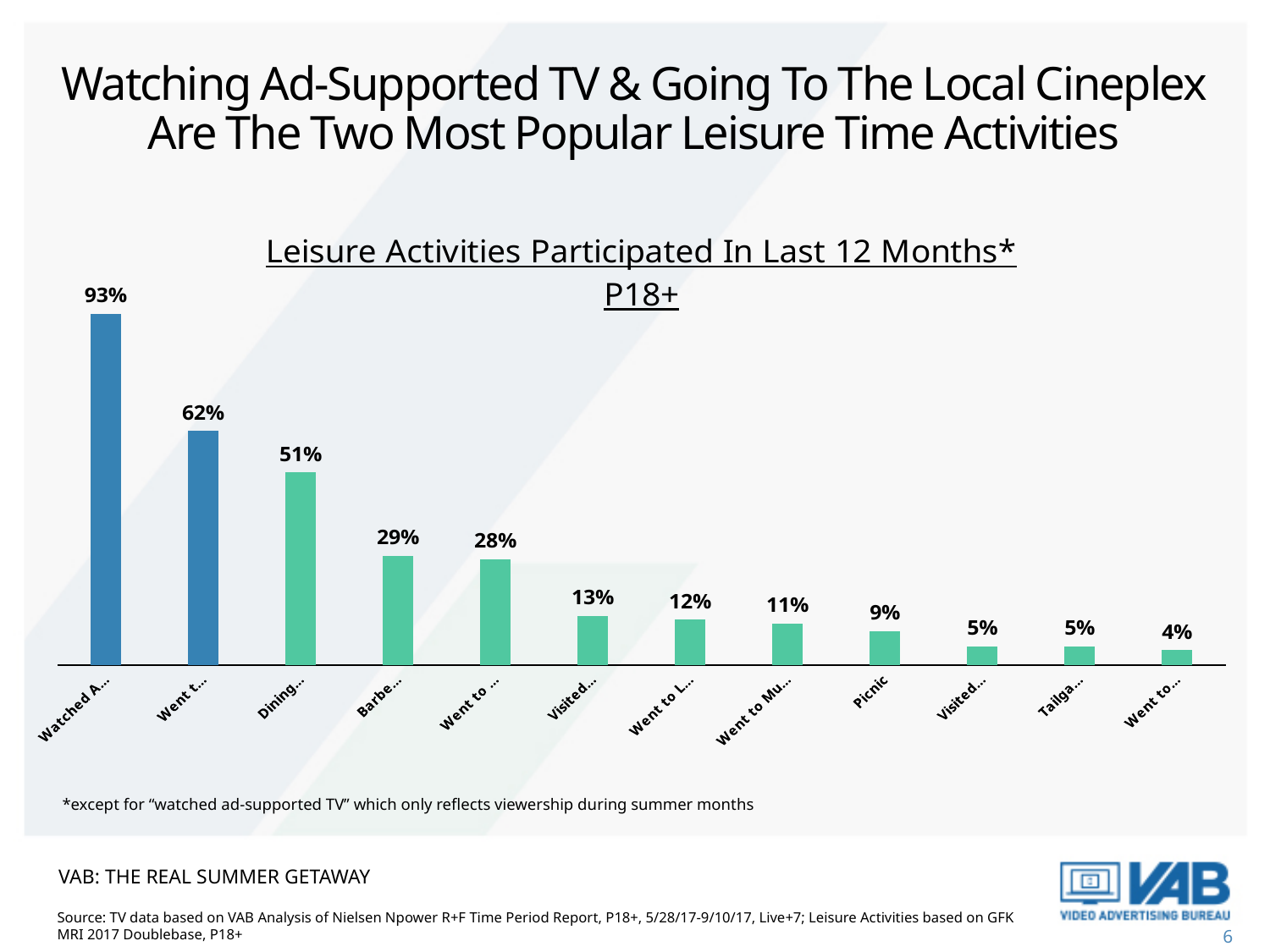
What is the difference between the leftmost bar (93%) and the second bar (62%)? 31% What is the difference between the third bar (51%) and Picnic (9%)? 42% What is the value for Picnic in the Leisure Activities chart? 9% What is the lowest value shown in the chart? 4% Do the values rise or fall moving from left to right along the x axis? fall How many bars (categories) are plotted in the chart? 12 What is the value of the second bar from the left in the chart? 62% What is the highest value shown in the chart? 93% What is the value of the rightmost bar in the chart? 4% What type of chart is shown on the slide? bar chart What is the title of the chart? Leisure Activities Participated In Last 12 Months* P18+ What is the value of the leftmost (tallest) bar in the chart? 93%